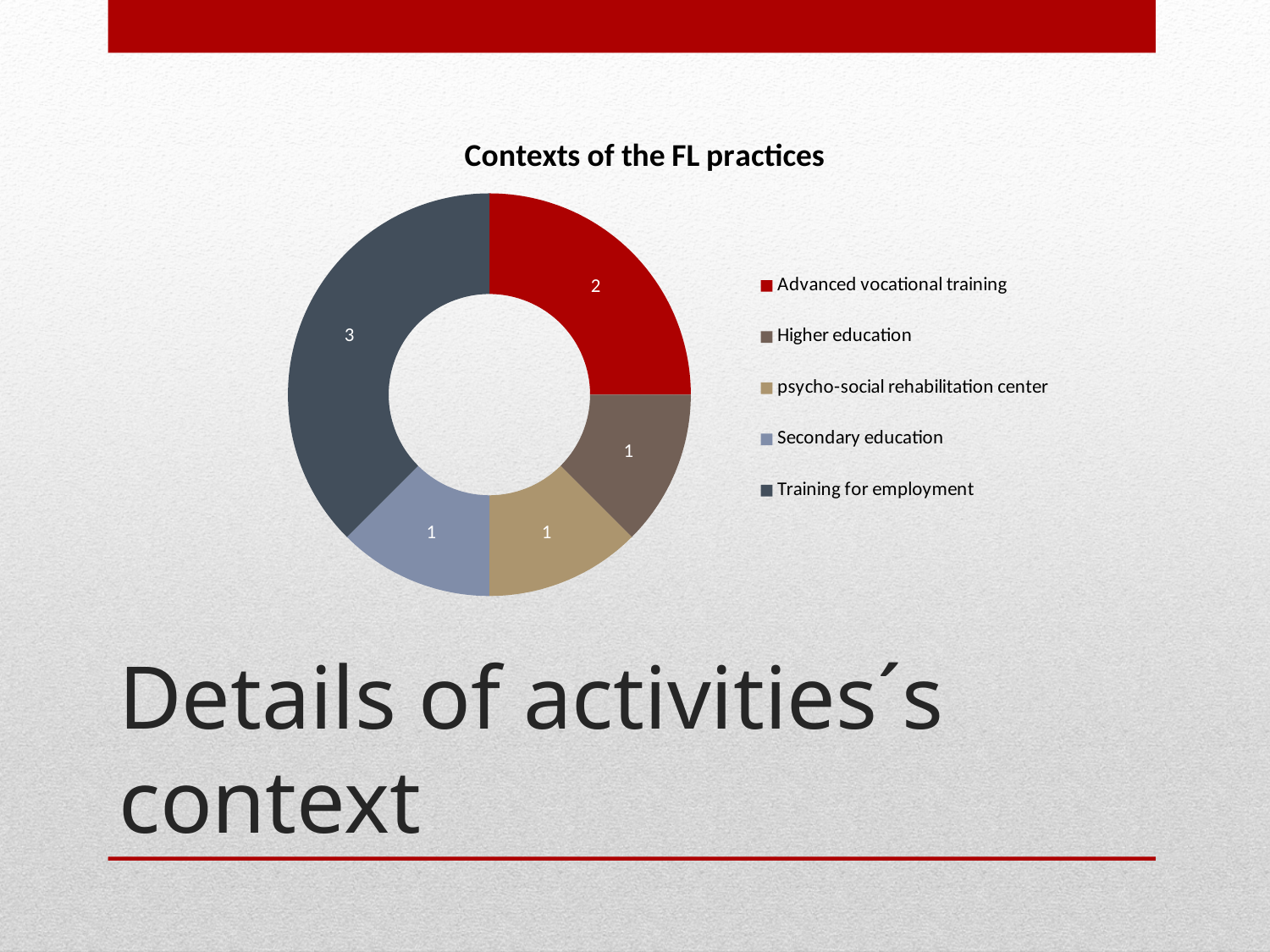
What is the difference between the values for Training for employment and Advanced vocational training? 1 What share of the total does Training for employment represent? 37.5% What is the value for Training for employment? 3 What kind of chart is shown on the slide? doughnut chart Which colour represents Advanced vocational training in the chart? red What is the total of all the values in the chart? 8 Which category has the highest value? Training for employment How many categories does the legend list? 5 What is the value for Advanced vocational training? 2 Which is larger, the value for Advanced vocational training or the value for Secondary education? Advanced vocational training What is the value for Higher education? 1 What is the title of the chart? Contexts of the FL practices